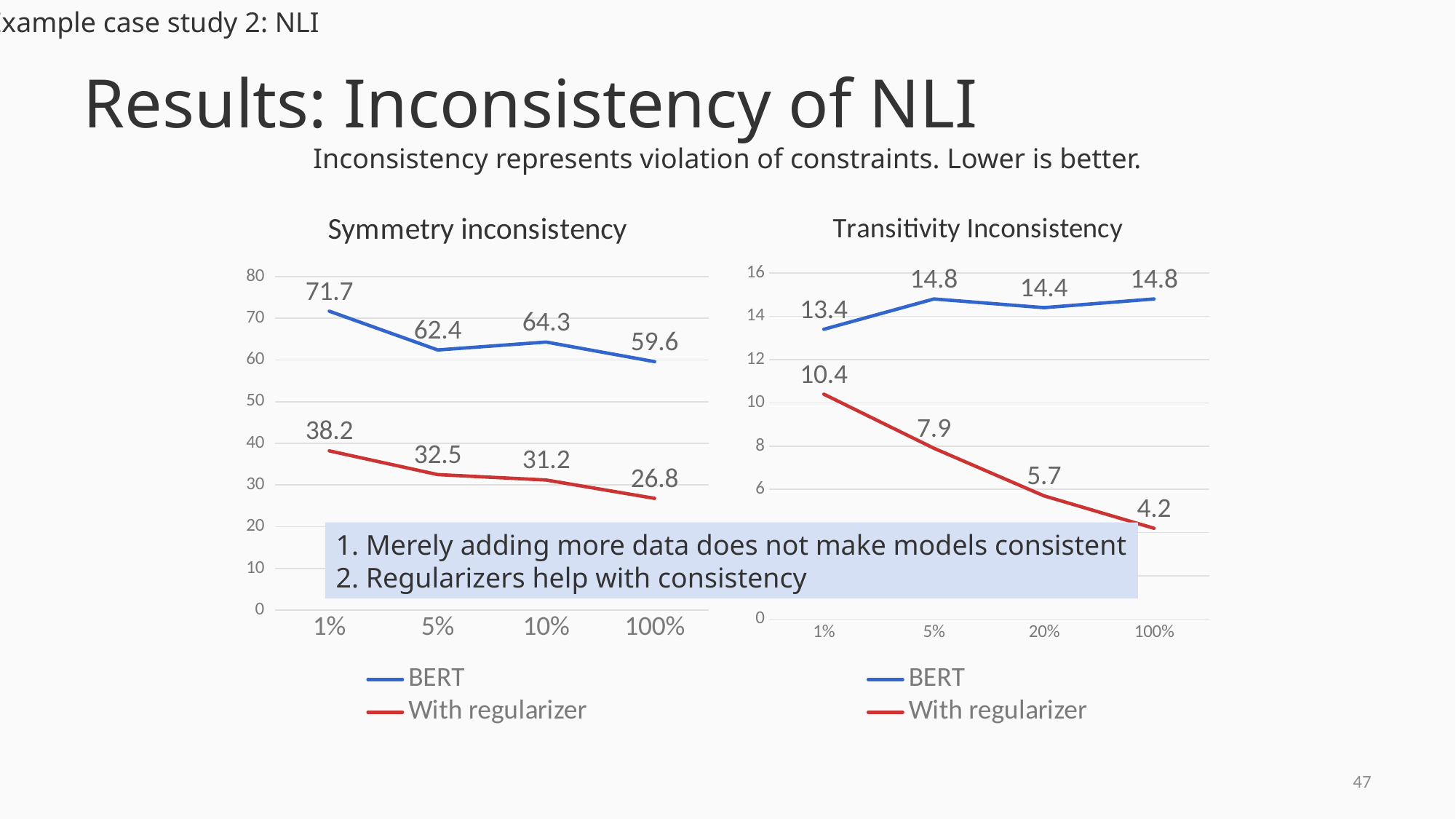
In the Transitivity Inconsistency chart, what is the BERT value at 1%? 13.4 In the Symmetry inconsistency chart, what is the difference between the BERT and With regularizer values at 5%? 29.9 How many series does the legend of the Symmetry inconsistency chart list? 2 In the Transitivity Inconsistency chart, what is the With regularizer value at 20%? 5.7 In the Symmetry inconsistency chart, at which x-axis category is the BERT value lowest? 100% In the Transitivity Inconsistency chart, which series has the larger value at 100%, BERT or With regularizer? BERT In the Transitivity Inconsistency chart, does the With regularizer line rise or fall from 1% to 100%? fall In the Symmetry inconsistency chart, what is the BERT value at 1%? 71.7 What kind of chart is the Transitivity Inconsistency chart? line chart In the Transitivity Inconsistency chart, what is the difference between the With regularizer values at 1% and 100%? 6.2 In the Symmetry inconsistency chart, what is the With regularizer value at 100%? 26.8 In the Transitivity Inconsistency chart, at which x-axis category is the With regularizer value highest? 1%